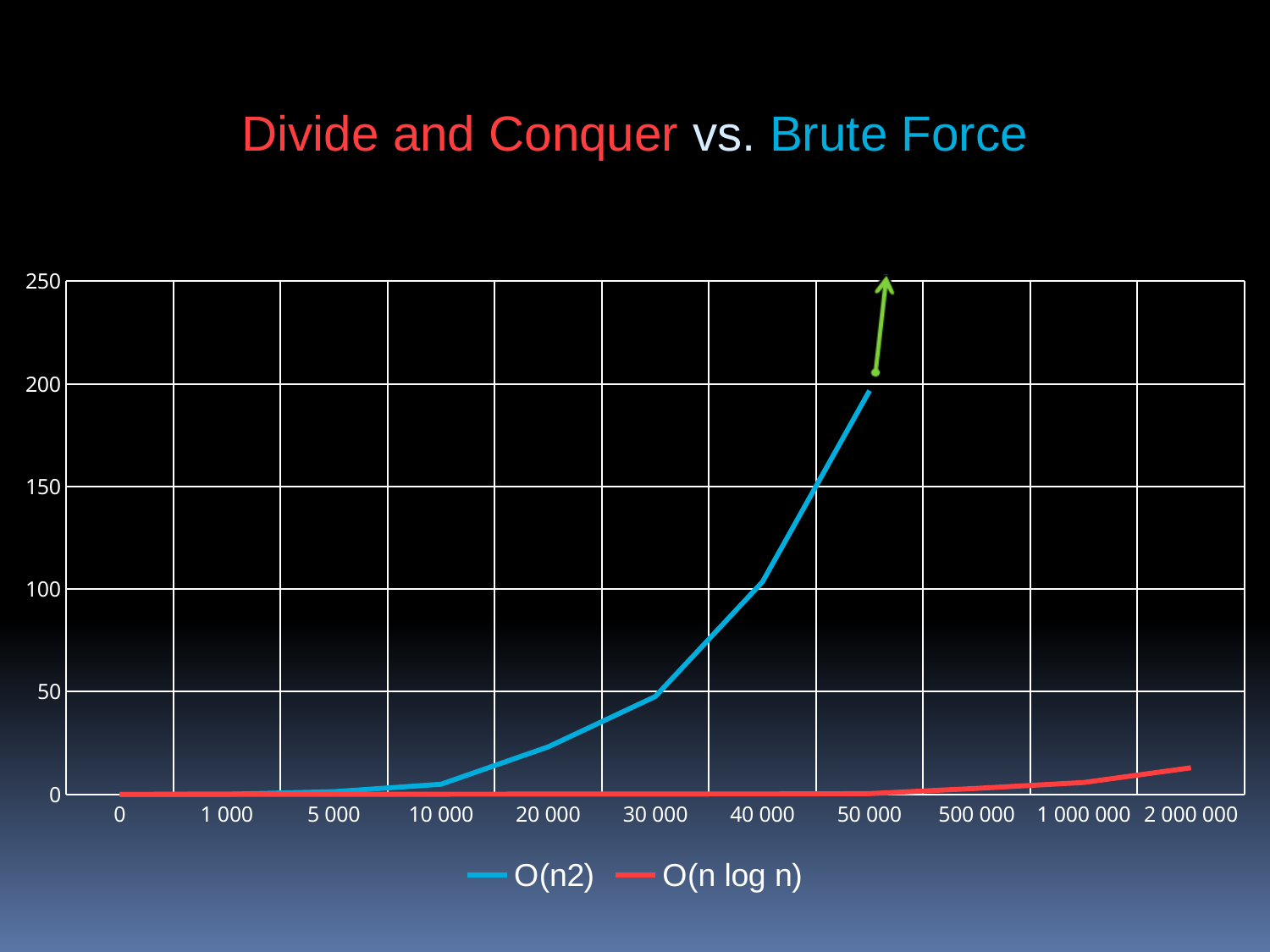
What kind of chart is shown on the slide? line chart Is the value of O(n2) at 50 000 greater or less than 150? greater At which x-axis category does the O(n2) series reach its highest value? 50 000 At 40 000, which series has the larger value, O(n2) or O(n log n)? O(n2) How many series does the legend list? 2 What colour is the O(n log n) line? red How many categories are shown on the x axis? 11 Is the value of O(n log n) at 2 000 000 greater or less than 50? less Is the value of O(n2) at 10 000 greater or less than 50? less Does the O(n2) line rise or fall from 0 to 50 000? rise What is the title of the chart? Divide and Conquer vs. Brute Force